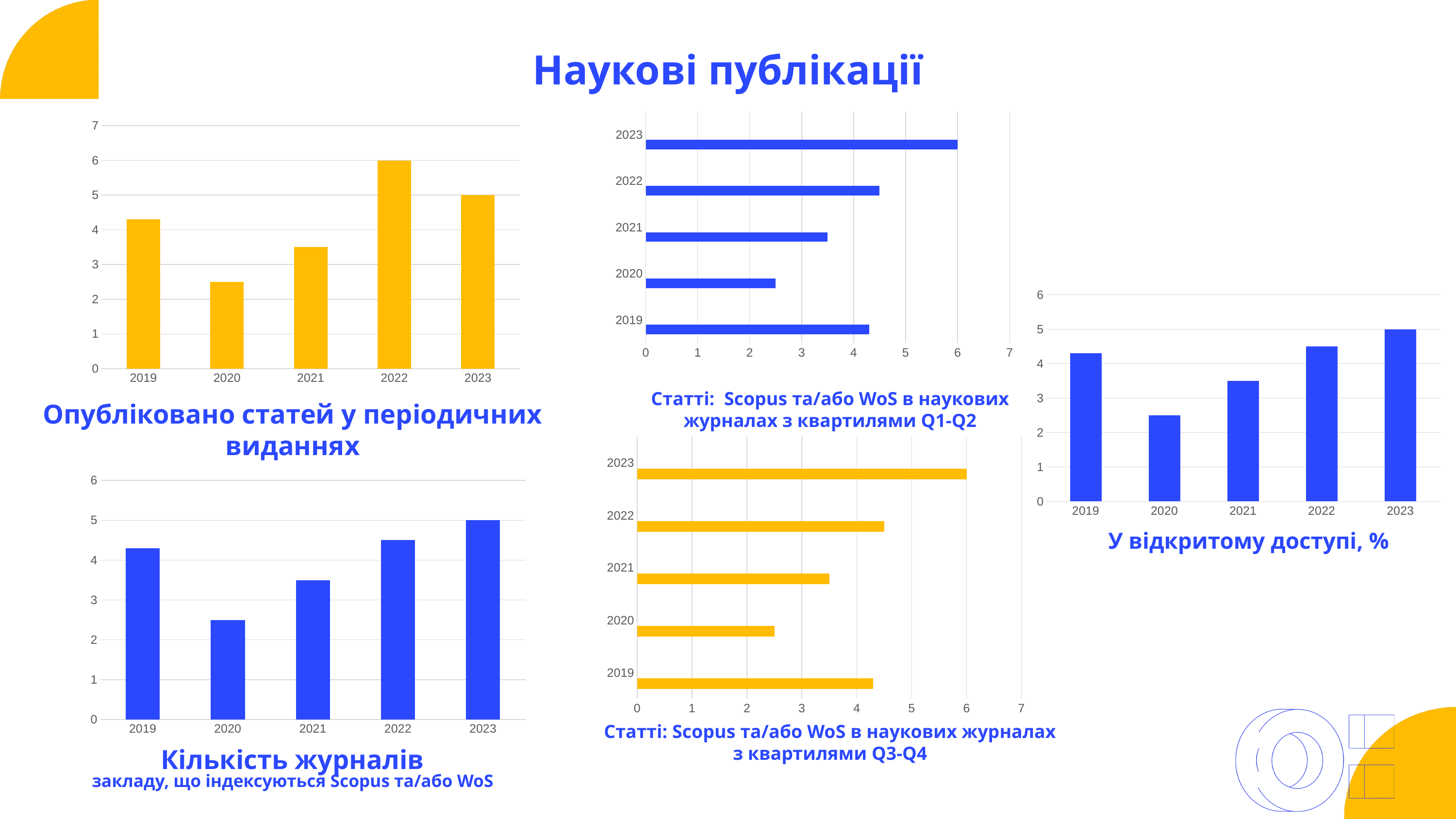
What kind of chart is the one titled 'Статті: Scopus та/або WoS в наукових журналах з квартилями Q3-Q4'? bar chart In the chart titled 'У відкритому доступі, %', do the values rise or fall from 2020 to 2023? rise In the chart titled 'Кількість журналів', what is the value for 2023? 5 In the chart titled 'Опубліковано статей у періодичних виданнях', which year has the highest value? 2022 In the chart titled 'Статті: Scopus та/або WoS в наукових журналах з квартилями Q1-Q2', what is the value for 2023? 6 In the chart titled 'Опубліковано статей у періодичних виданнях', which year has the lowest value? 2020 How many years are shown in the chart titled 'У відкритому доступі, %'? 5 In the chart titled 'Статті: Scopus та/або WoS в наукових журналах з квартилями Q3-Q4', is the value for 2019 greater or less than 4? greater In the chart titled 'Опубліковано статей у періодичних виданнях', what is the value for 2022? 6 In the chart titled 'Статті: Scopus та/або WoS в наукових журналах з квартилями Q3-Q4', which year has the lowest value? 2020 In the chart titled 'Кількість журналів', which is larger, the value for 2021 or the value for 2022? 2022 In the chart titled 'Статті: Scopus та/або WoS в наукових журналах з квартилями Q1-Q2', is the value for 2020 greater or less than 3? less